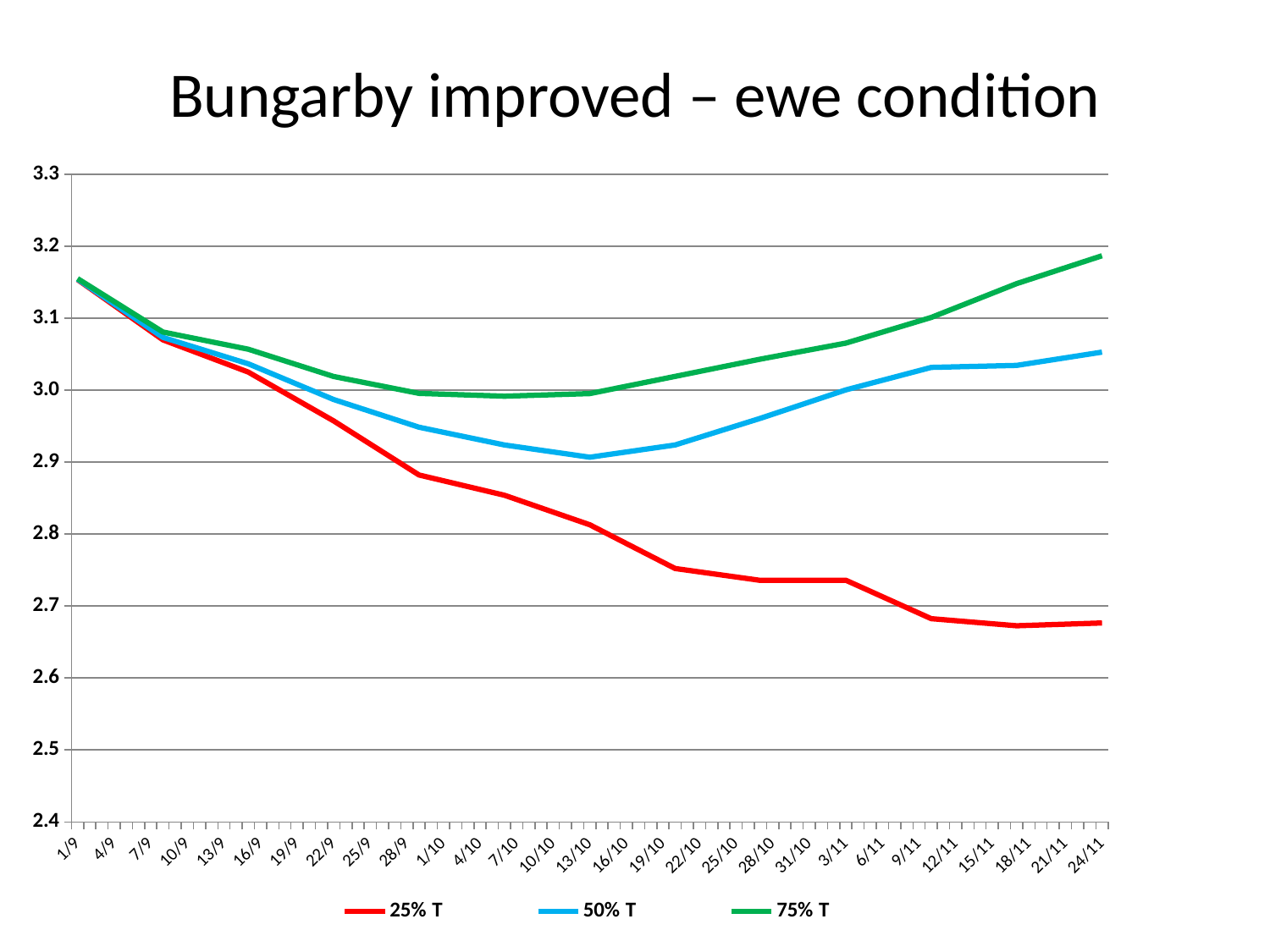
What kind of chart is shown on the slide? line chart Is the value for 75% T at 24/11 greater or less than 3.1? greater How many dates are labelled along the x axis? 29 How many series does the legend list? 3 Does the 25% T series rise or fall overall from 1/9 to 24/11? fall What is the title of the chart? Bungarby improved – ewe condition At 24/11, which is larger: the value for 50% T or the value for 25% T? 50% T Is the value for 50% T at 24/11 greater or less than 3.0? greater Which series has the highest value at 24/11? 75% T Which series is drawn in red? 25% T Which series has the lowest value at 24/11? 25% T Is the value for 25% T at 24/11 greater or less than 2.7? less